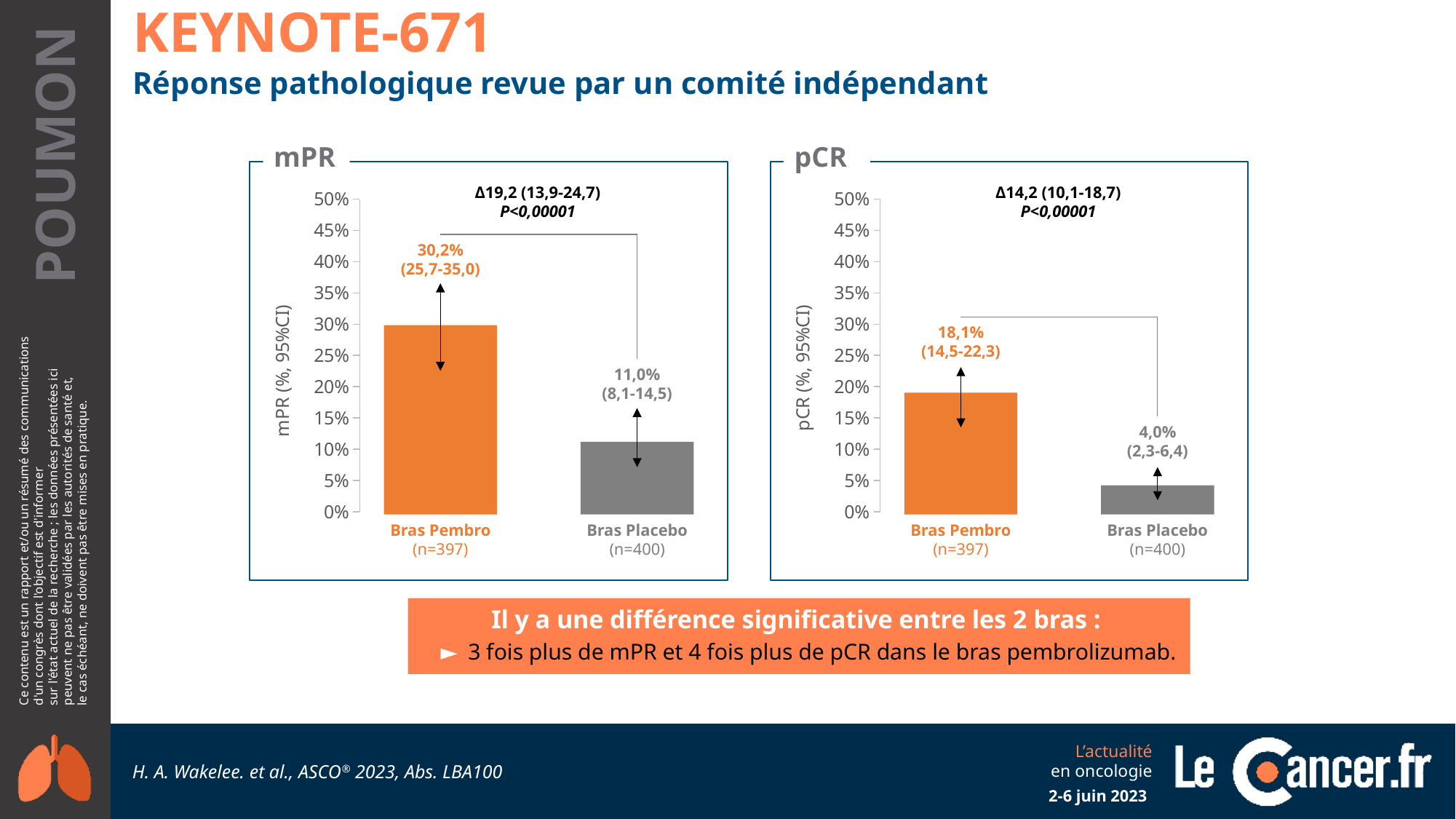
In the mPR chart, is the value for Bras Placebo greater or less than 15%? less In the mPR chart, what is the value for Bras Placebo? 11,0% In the mPR chart, what is the difference between the Bras Pembro and Bras Placebo values? 19,2 How many bars are shown in the pCR chart? 2 What kind of chart is the mPR chart? Bar chart In the mPR chart, what is the value for Bras Pembro? 30,2% In the pCR chart, which arm has the lowest value? Bras Placebo In the pCR chart, what is the value for Bras Placebo? 4,0% In the pCR chart, what is the value for Bras Pembro? 18,1% In the pCR chart, is the value for Bras Pembro greater or less than 15%? greater In the pCR chart, what is the 95% confidence interval printed for Bras Placebo? (2,3-6,4) In the mPR chart, which arm has the highest value? Bras Pembro